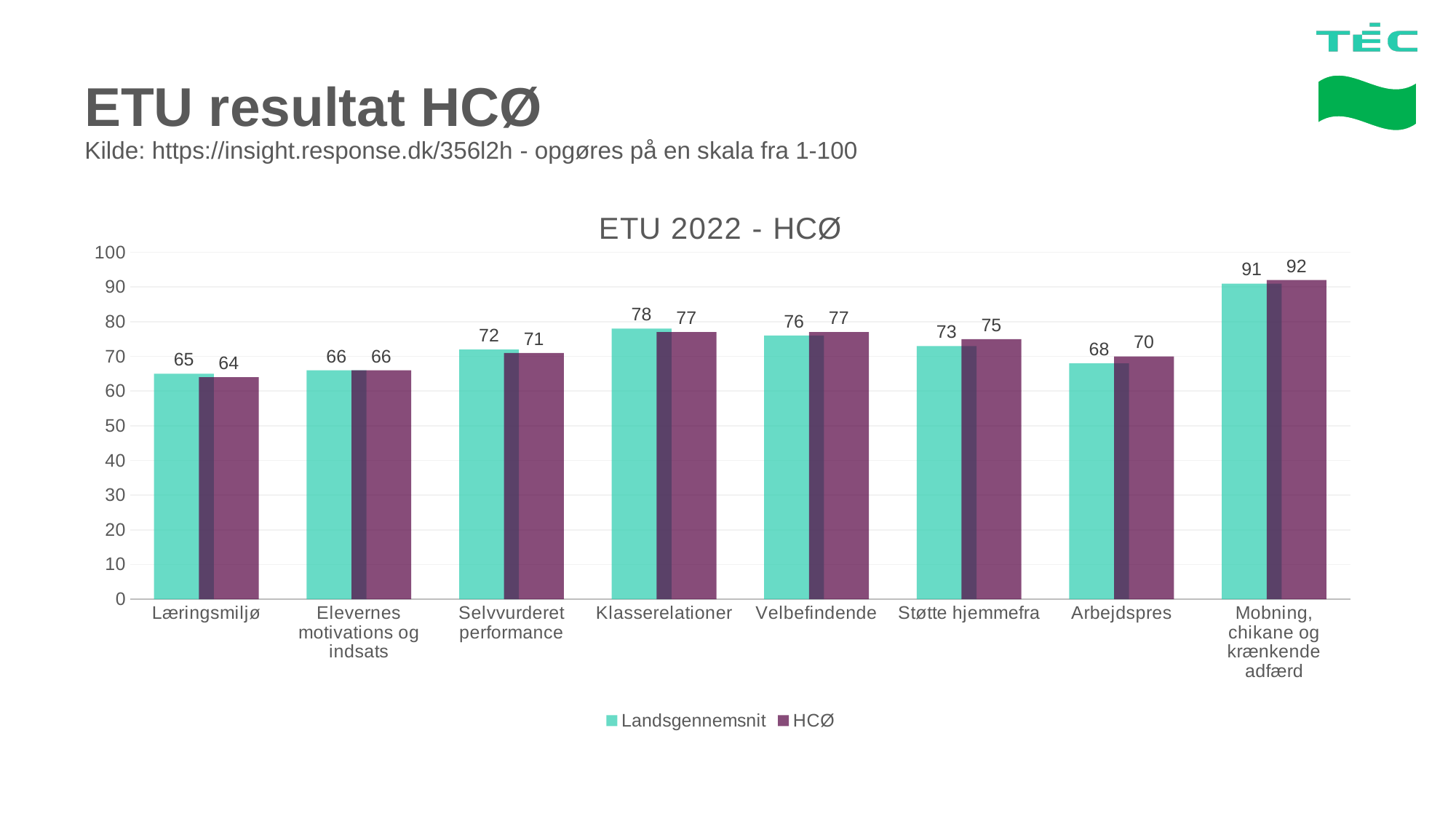
What is the title of the chart? ETU 2022 - HCØ How many categories are shown on the x axis? 8 Is the HCØ value for Velbefindende greater or less than 70? greater Which category has the lowest Landsgennemsnit value? Læringsmiljø Which category has the highest HCØ value? Mobning, chikane og krænkende adfærd What is the Landsgennemsnit value for Klasserelationer? 78 How many series does the legend list? 2 What is the difference between the HCØ and Landsgennemsnit values for Arbejdspres? 2 What kind of chart is shown? bar chart Which is larger for Selvvurderet performance: Landsgennemsnit or HCØ? Landsgennemsnit What is the HCØ value for Mobning, chikane og krænkende adfærd? 92 What is the HCØ value for Støtte hjemmefra? 75